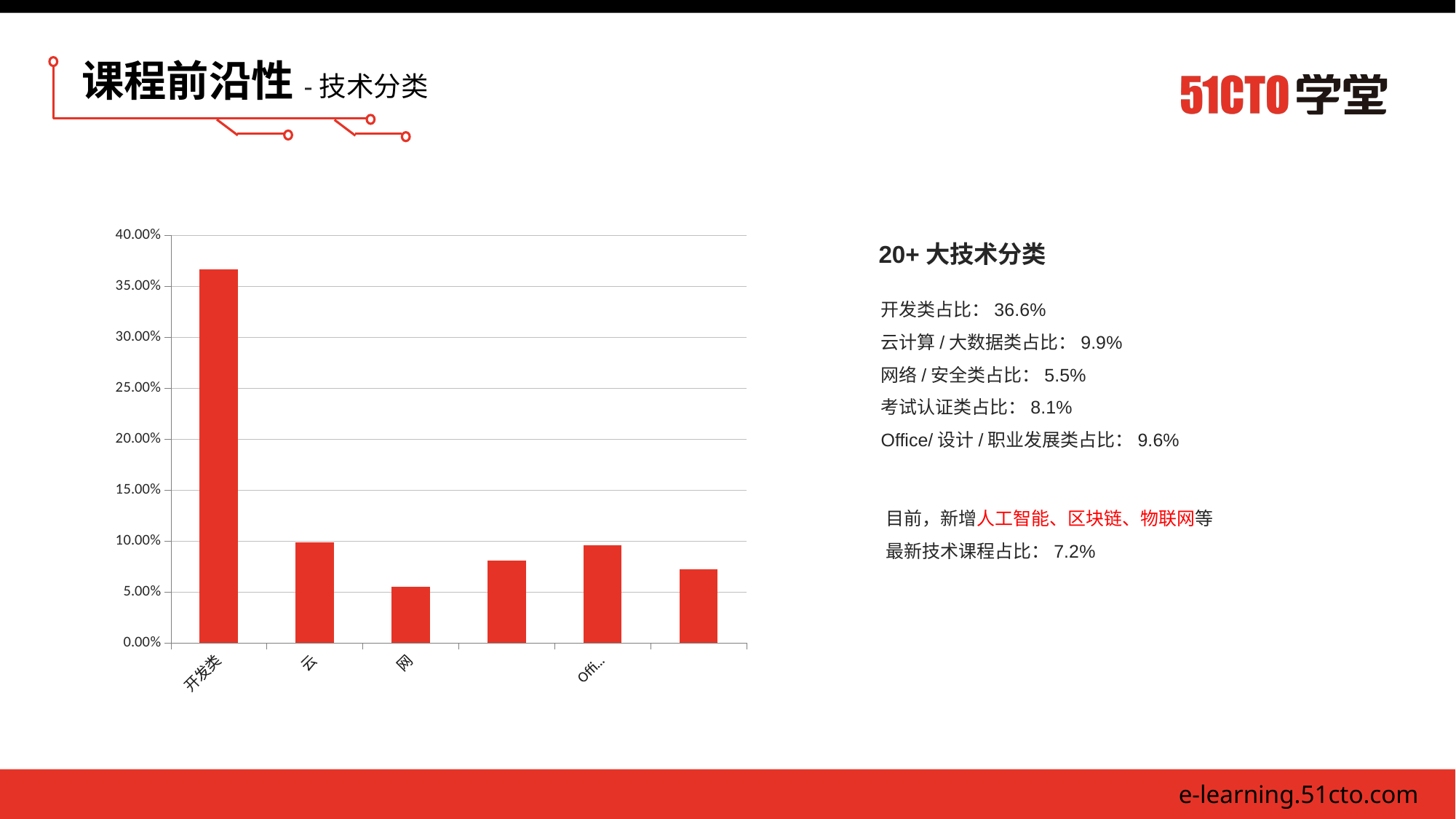
Is the value for 云 greater or less than 5.00%? greater How many bars are plotted in the chart? 6 Which is larger, the value for 云 or the value for 网? 云 What colour are the bars in the chart? red What is the highest value shown on the chart's vertical axis? 40.00% Which labelled category has the lowest bar in the chart? 网 What kind of chart is shown on the slide? bar chart According to the slide, what is the share for 网络 / 安全类? 5.5% Which category has the highest bar in the chart? 开发类 According to the slide, what is the share for 开发类? 36.6% Is the value for 网 greater or less than 10.00%? less Is the value for 开发类 greater or less than 35.00%? greater